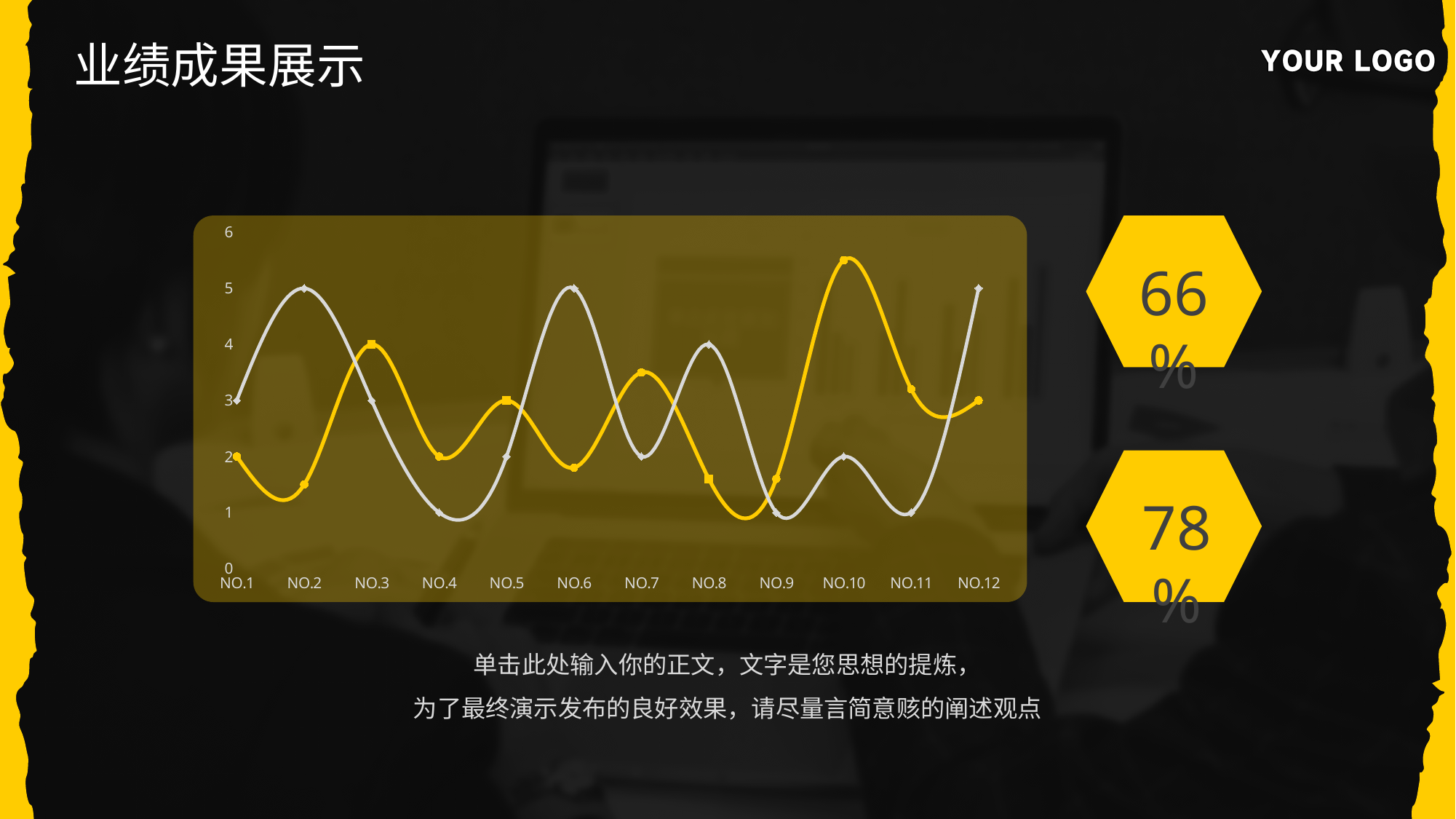
At NO.2, which line has the larger value, the yellow line or the grey line? grey line What is the value of the yellow line at NO.1? 2 What is the value of the yellow line at NO.3? 4 What is the title of the slide containing the chart? 业绩成果展示 What kind of chart is shown on the slide? line chart What is the difference between the grey line's value at NO.2 and its value at NO.1? 2 How many categories are shown on the x axis of the chart? 12 Is the value of the grey line at NO.4 greater or less than 2? less At which category does the yellow line reach its highest value? NO.10 What is the value of the grey line at NO.1? 3 What is the value of the grey line at NO.2? 5 Is the value of the yellow line at NO.10 greater or less than 5? greater